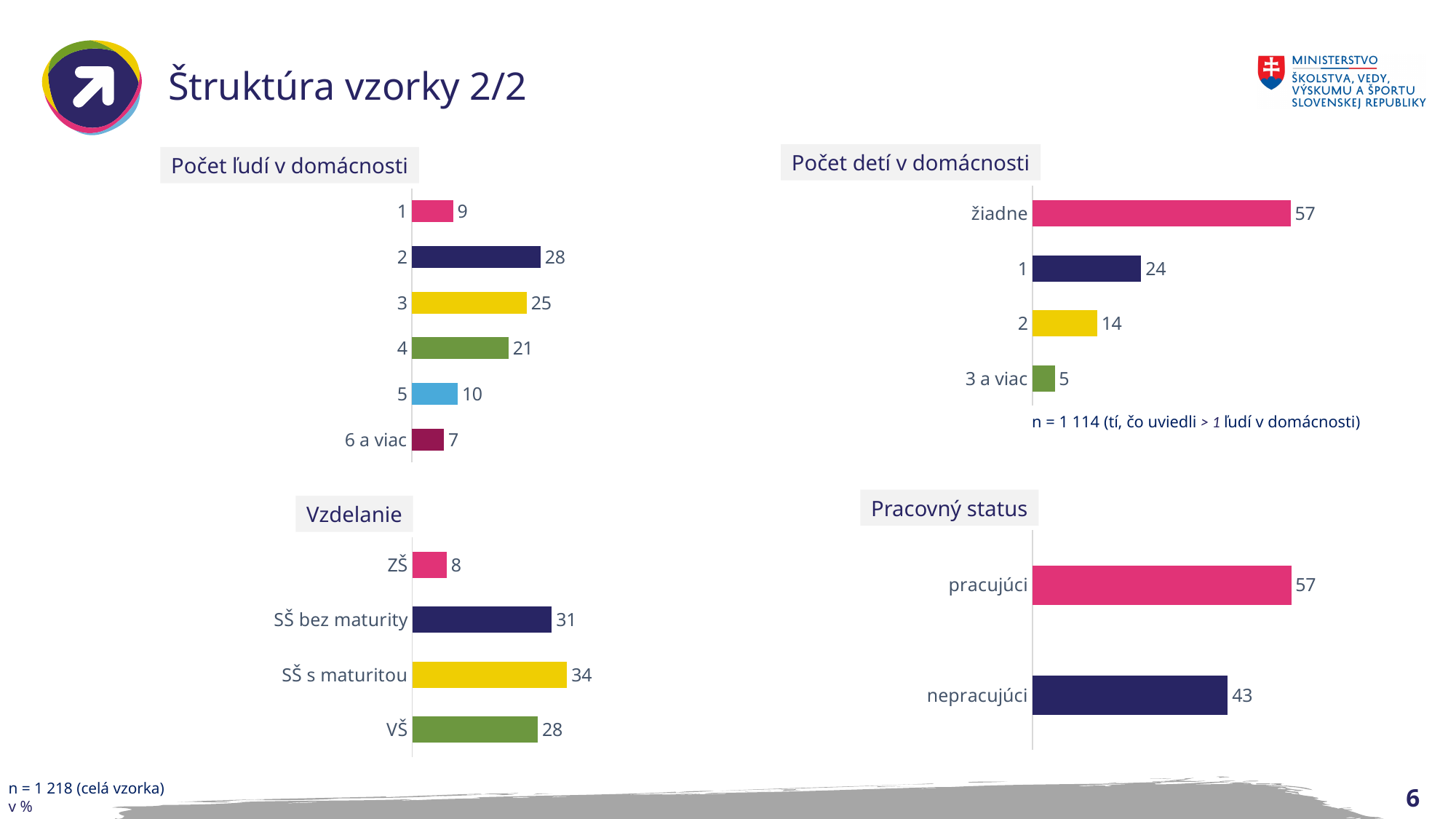
What type of chart is the 'Pracovný status' chart? bar chart In the 'Počet detí v domácnosti' chart, which category has the highest value? žiadne In the 'Vzdelanie' chart, what is the value for 'SŠ s maturitou'? 34 In the 'Počet detí v domácnosti' chart, what is the value for 'žiadne'? 57 In the 'Pracovný status' chart, what is the value for 'nepracujúci'? 43 In the 'Počet ľudí v domácnosti' chart, how many categories are shown? 6 In the 'Vzdelanie' chart, which category has the lowest value? ZŠ In the 'Počet detí v domácnosti' chart, what is the difference between the values for 1 and 2? 10 In the 'Pracovný status' chart, what is the difference between 'pracujúci' and 'nepracujúci'? 14 In the 'Počet ľudí v domácnosti' chart, what is the value for category 2? 28 In the 'Vzdelanie' chart, which is larger, 'SŠ bez maturity' or 'VŠ'? SŠ bez maturity In the 'Počet ľudí v domácnosti' chart, which category has the lowest value? 6 a viac